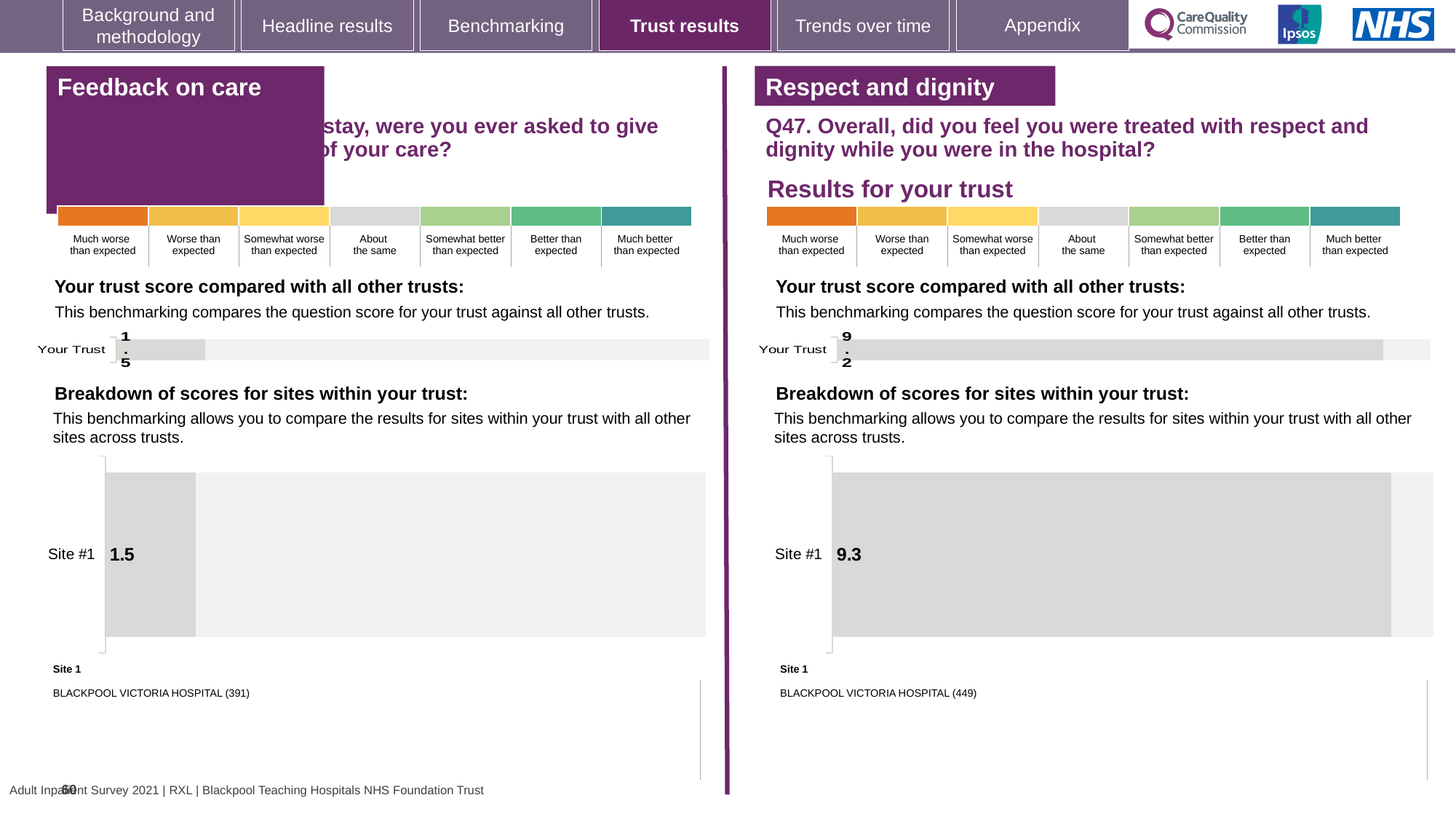
In the 'Respect and dignity' section, what is the difference between the Site #1 score and the Your Trust score? 0.1 Which hospital is listed as Site 1 below the site breakdown chart in the 'Feedback on care' section? BLACKPOOL VICTORIA HOSPITAL (391) What is the difference between the Site #1 score in the 'Respect and dignity' section (9.3) and the Site #1 score in the 'Feedback on care' section (1.5)? 7.8 What kind of chart is used to show the Site #1 score in the 'Respect and dignity' section? Bar chart In the 'Feedback on care' section, what score is shown for Site #1 in the 'Breakdown of scores for sites within your trust' chart? 1.5 How many sites are shown in the 'Breakdown of scores for sites within your trust' chart in the 'Feedback on care' section? 1 In the 'Feedback on care' section, what is the score shown for Your Trust in the 'Your trust score compared with all other trusts' chart? 1.5 Which hospital is listed as Site 1 below the site breakdown chart in the 'Respect and dignity' section? BLACKPOOL VICTORIA HOSPITAL (449) In the 'Respect and dignity' section, what score is shown for Site #1 in the 'Breakdown of scores for sites within your trust' chart? 9.3 In the 'Respect and dignity' section, what is the score shown for Your Trust in the 'Your trust score compared with all other trusts' chart? 9.2 Which is larger: the Site #1 score in the 'Respect and dignity' section or the Site #1 score in the 'Feedback on care' section? Respect and dignity In the 'Feedback on care' section, what is the difference between the Site #1 score and the Your Trust score? 0